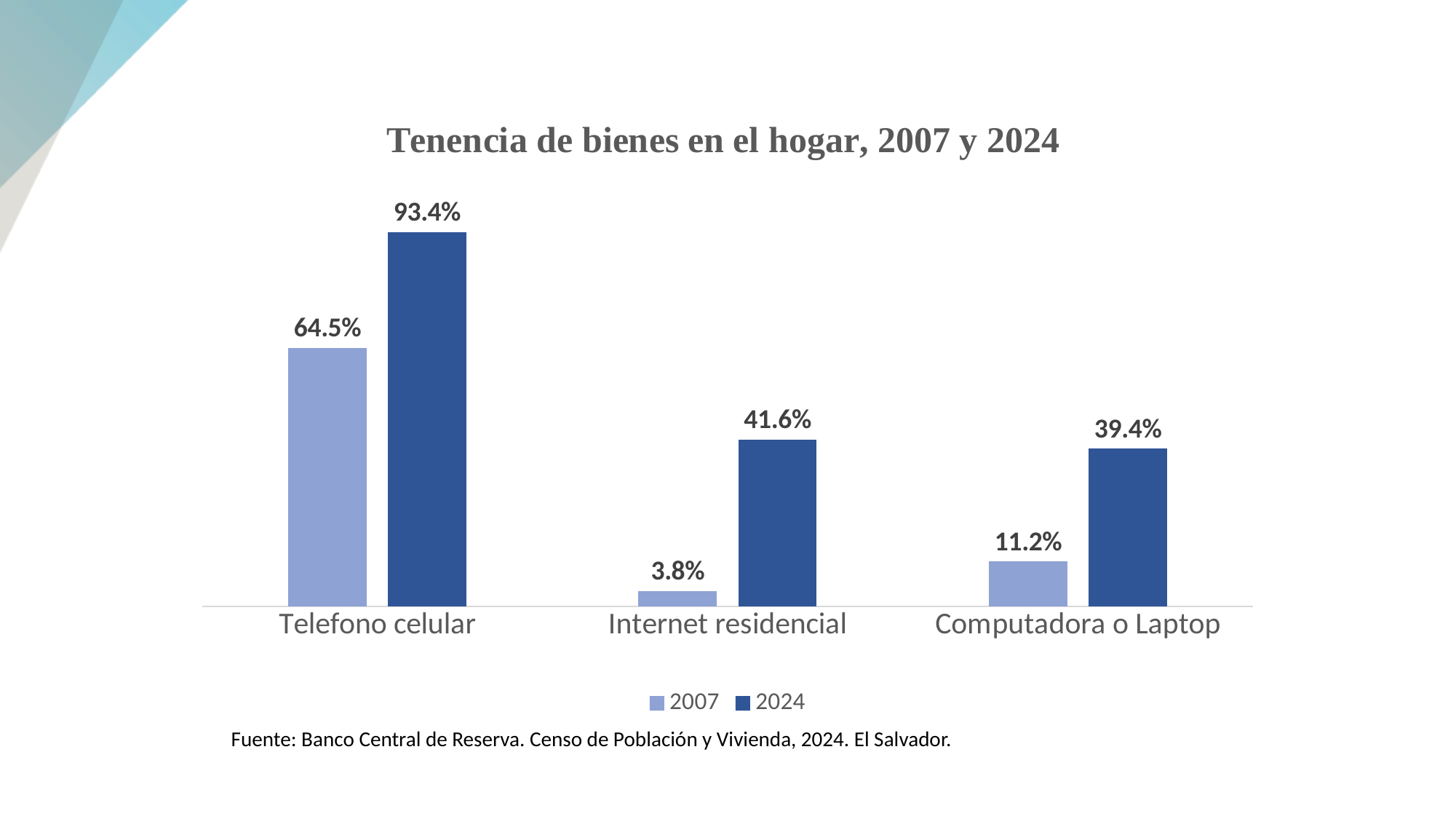
What is the difference between the 2024 and 2007 values for Internet residencial? 37.8% What is the difference between the 2024 and 2007 values for Telefono celular? 28.9% What is the value for Telefono celular in 2024? 93.4% Which is larger: the 2024 value for Internet residencial or the 2024 value for Computadora o Laptop? Internet residencial Which category has the highest value in 2024? Telefono celular Which category has the lowest value in 2007? Internet residencial What is the value for Computadora o Laptop in 2007? 11.2% How many series does the legend list? 2 What kind of chart is shown on the slide? Bar chart How many categories are shown on the x axis? 3 What is the value for Internet residencial in 2007? 3.8% What is the value for Computadora o Laptop in 2024? 39.4%